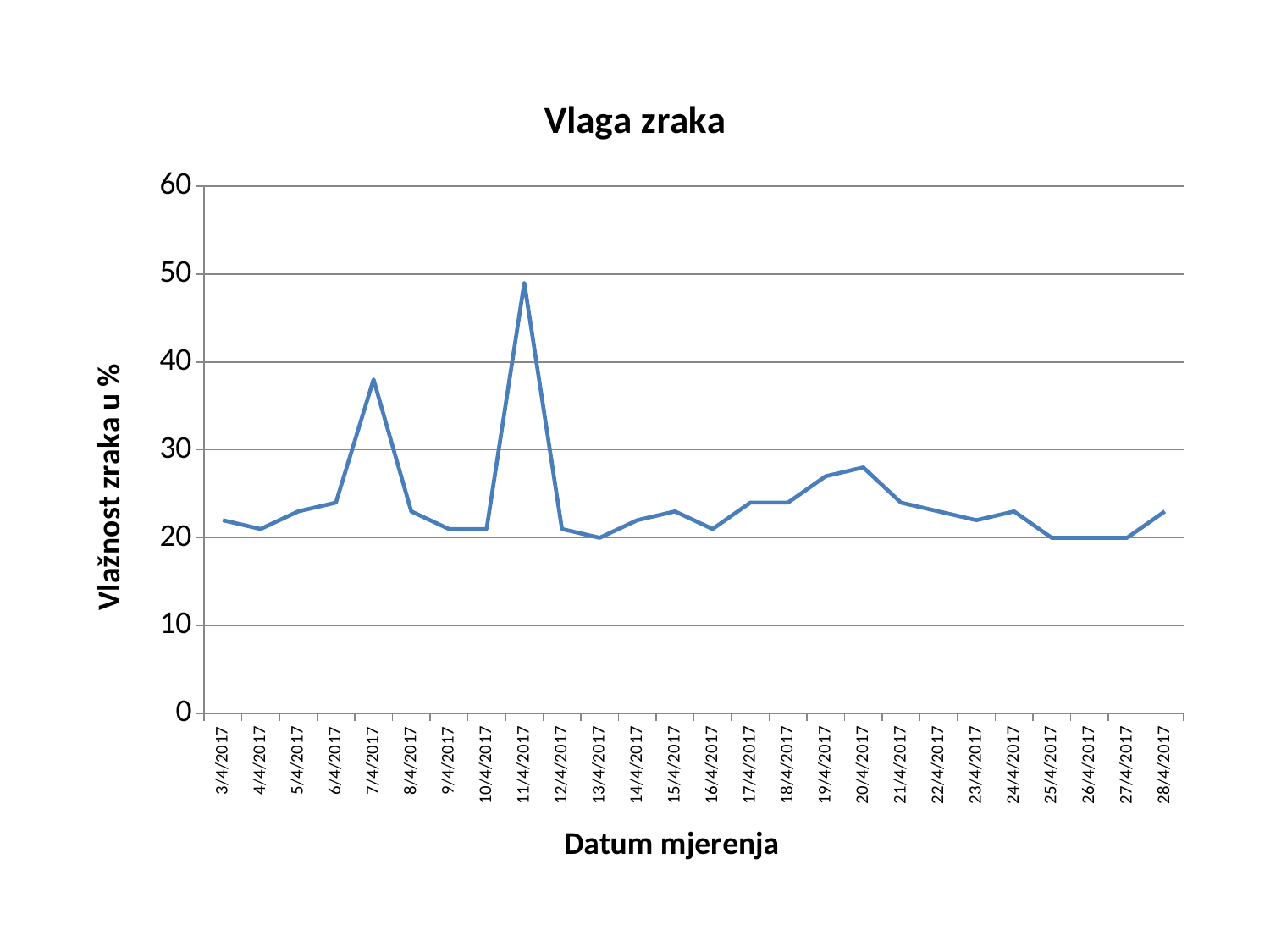
Is the value for 20/4/2017 greater or less than 30? less Do the values rise or fall from 11/4/2017 to 13/4/2017? fall On which date is the humidity value highest? 11/4/2017 What is the title of the chart? Vlaga zraka Which date has the larger value, 13/4/2017 or 20/4/2017? 20/4/2017 Is the value for 11/4/2017 greater or less than 40? greater What type of chart is shown on the slide? line chart Is the value for 9/4/2017 greater or less than 30? less What is the label of the vertical axis? Vlažnost zraka u % Which date has the larger value, 7/4/2017 or 11/4/2017? 11/4/2017 How many dates are plotted on the x axis? 26